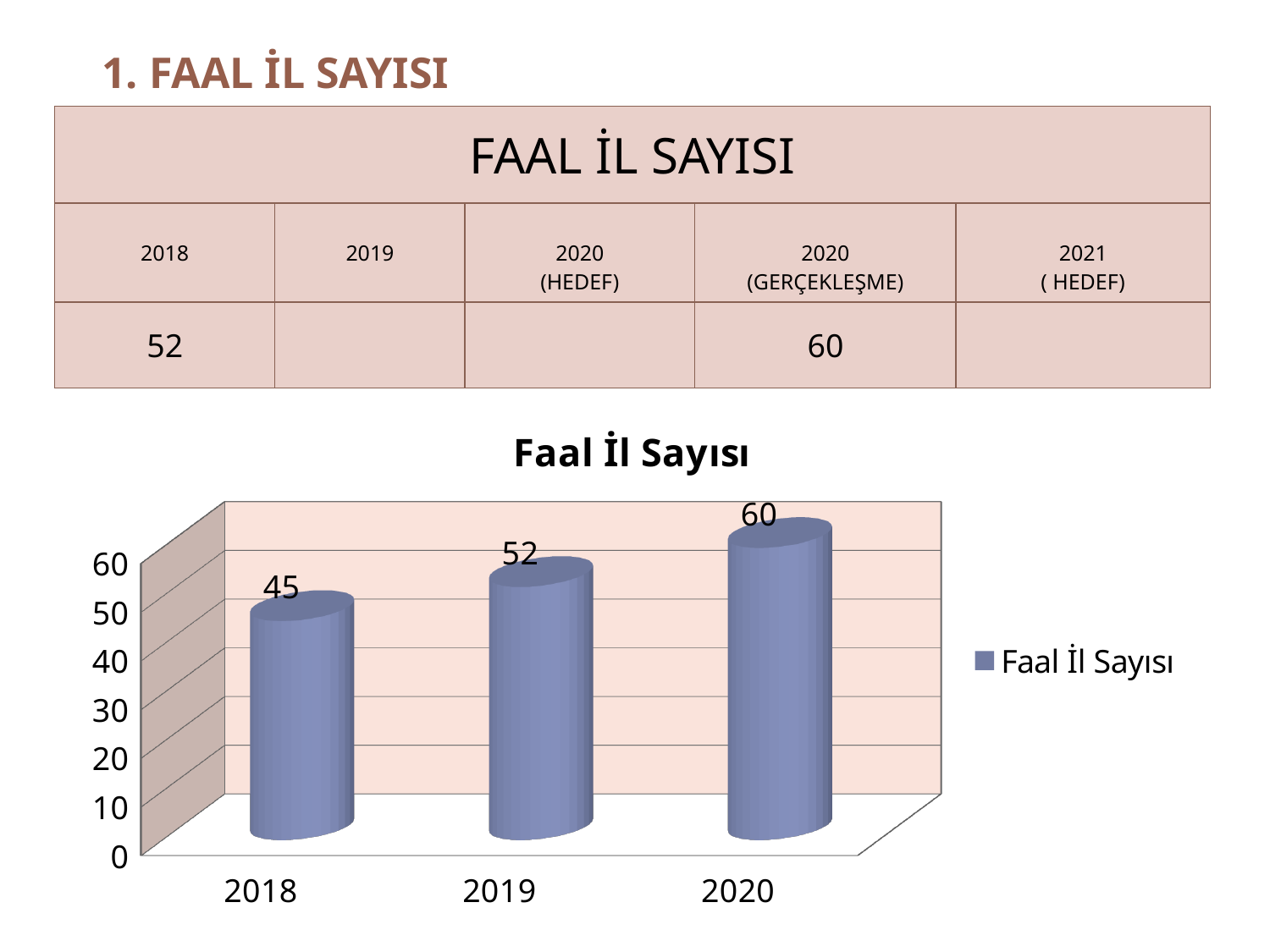
Which year has the lowest value in the Faal İl Sayısı chart? 2018 Do the values in the Faal İl Sayısı chart rise or fall from 2018 to 2020? Rise How many series does the legend of the Faal İl Sayısı chart list? 1 What is the difference between the values for 2019 and 2018 in the Faal İl Sayısı chart? 7 Which is larger in the Faal İl Sayısı chart, the value for 2019 or the value for 2020? 2020 What kind of chart is the Faal İl Sayısı chart? Bar chart What is the value for 2019 in the Faal İl Sayısı chart? 52 What is the difference between the values for 2020 and 2018 in the Faal İl Sayısı chart? 15 What is the value for 2020 in the Faal İl Sayısı chart? 60 How many years are shown on the x axis of the Faal İl Sayısı chart? 3 Which year has the highest value in the Faal İl Sayısı chart? 2020 What is the value for 2018 in the Faal İl Sayısı chart? 45